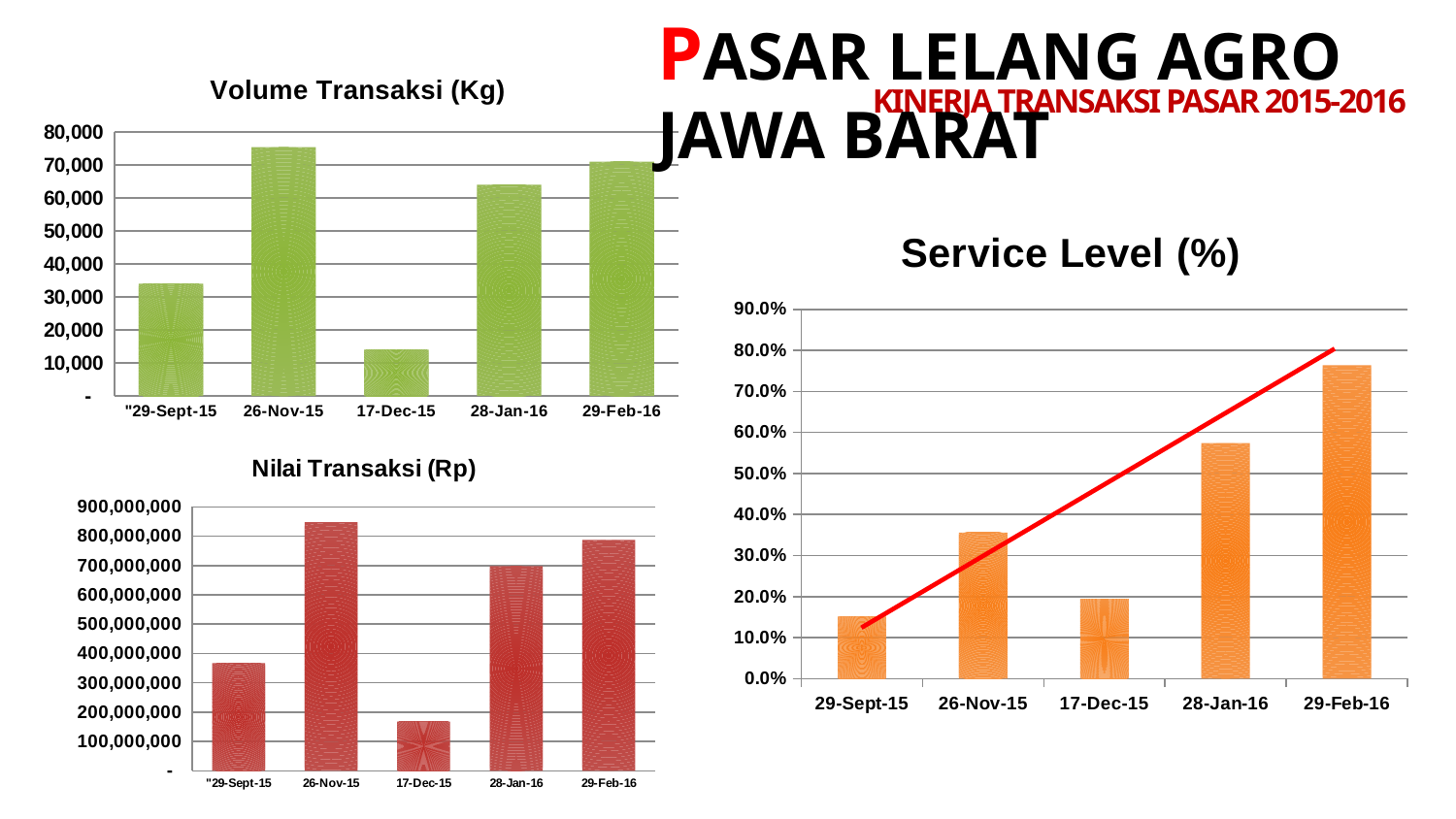
In the Nilai Transaksi (Rp) chart, which is larger, the value for 29-Sept-15 or 29-Feb-16? 29-Feb-16 In the Service Level (%) chart, is the value for 28-Jan-16 greater or less than 50.0%? greater What kind of chart is the Service Level (%) chart? bar chart In the Volume Transaksi (Kg) chart, is the value for 17-Dec-15 greater or less than 20,000? less In the Nilai Transaksi (Rp) chart, which date has the highest value? 26-Nov-15 In the Service Level (%) chart, which date has the highest service level? 29-Feb-16 In the Volume Transaksi (Kg) chart, which date has the lowest volume? 17-Dec-15 In the Nilai Transaksi (Rp) chart, which date has the lowest value? 17-Dec-15 In the Volume Transaksi (Kg) chart, which date has the highest volume? 26-Nov-15 In the Nilai Transaksi (Rp) chart, is the value for 28-Jan-16 greater or less than 600,000,000? greater How many dates are shown on the x axis of the Service Level (%) chart? 5